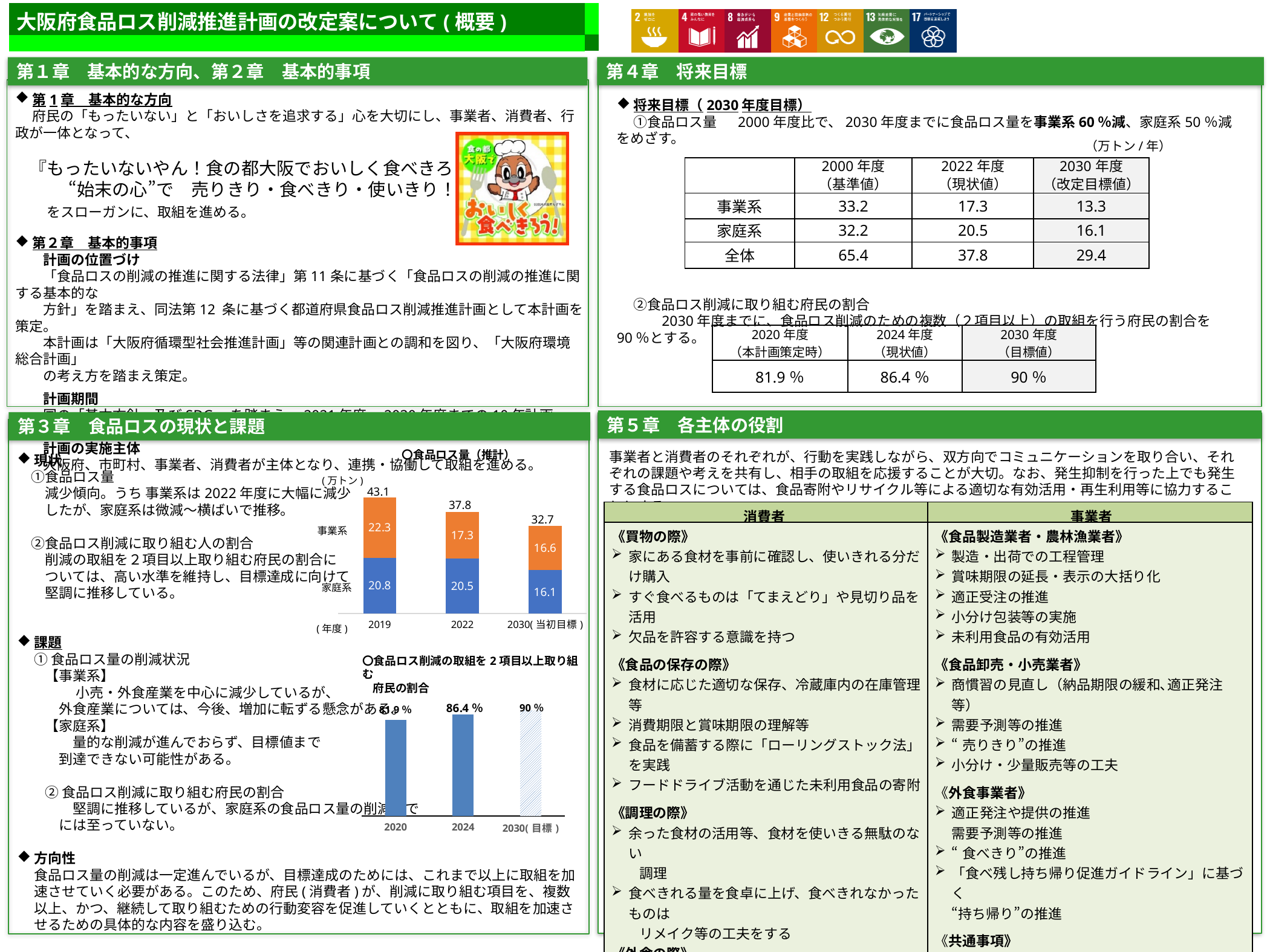
In the 府民の割合 chart, what is the difference between the 2024 value and the 2020 value? 4.5％ In the 食品ロス量（推計） chart, what is the 事業系 value for 2019? 22.3 In the 食品ロス量（推計） chart, what is the difference between the 事業系 values for 2019 and 2022? 5.0 In the 食品ロス量（推計） chart, which year has the highest total food loss? 2019 In the 食品ロス量（推計） chart, do the total values rise or fall from 2019 to 2030(当初目標)? Fall In the 府民の割合 chart, how many bars are shown? 3 What type of chart is the 食品ロス量（推計） chart? Stacked bar chart In the 府民の割合 chart (share of residents taking two or more food loss reduction actions), what is the value for 2024? 86.4％ In the 食品ロス量（推計） chart, what is the 家庭系 value for 2022? 20.5 In the 食品ロス量（推計） chart, which is larger in 2022, 事業系 or 家庭系? 家庭系 In the 食品ロス量（推計） chart, what is the total shown above the 2030(当初目標) bar? 32.7 In the 食品ロス量（推計） chart, how many series does the chart show? 2